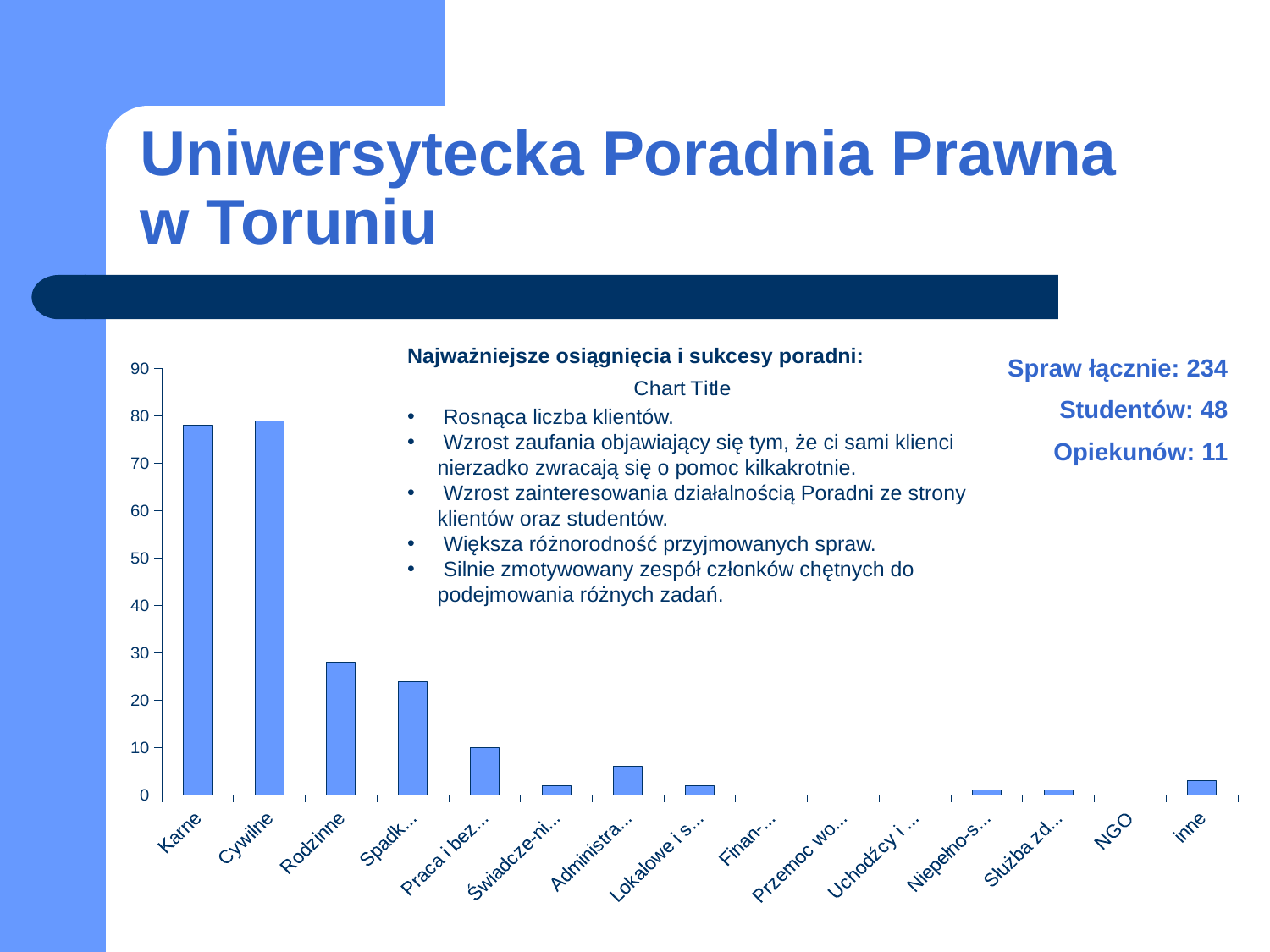
Is the value for Rodzinne greater or less than 20? greater Which is larger, the value for Karne or the value for Rodzinne? Karne Is the value for Cywilne greater or less than 70? greater How many categories are shown on the x axis of the chart? 15 What kind of chart is shown on the slide? bar chart Is the value for Karne greater or less than 70? greater Do the bar values generally rise or fall from left to right along the x axis? fall Which is larger, the value for Spadk... or the value for Praca i bez...? Spadk... What is the title shown above the chart? Chart Title